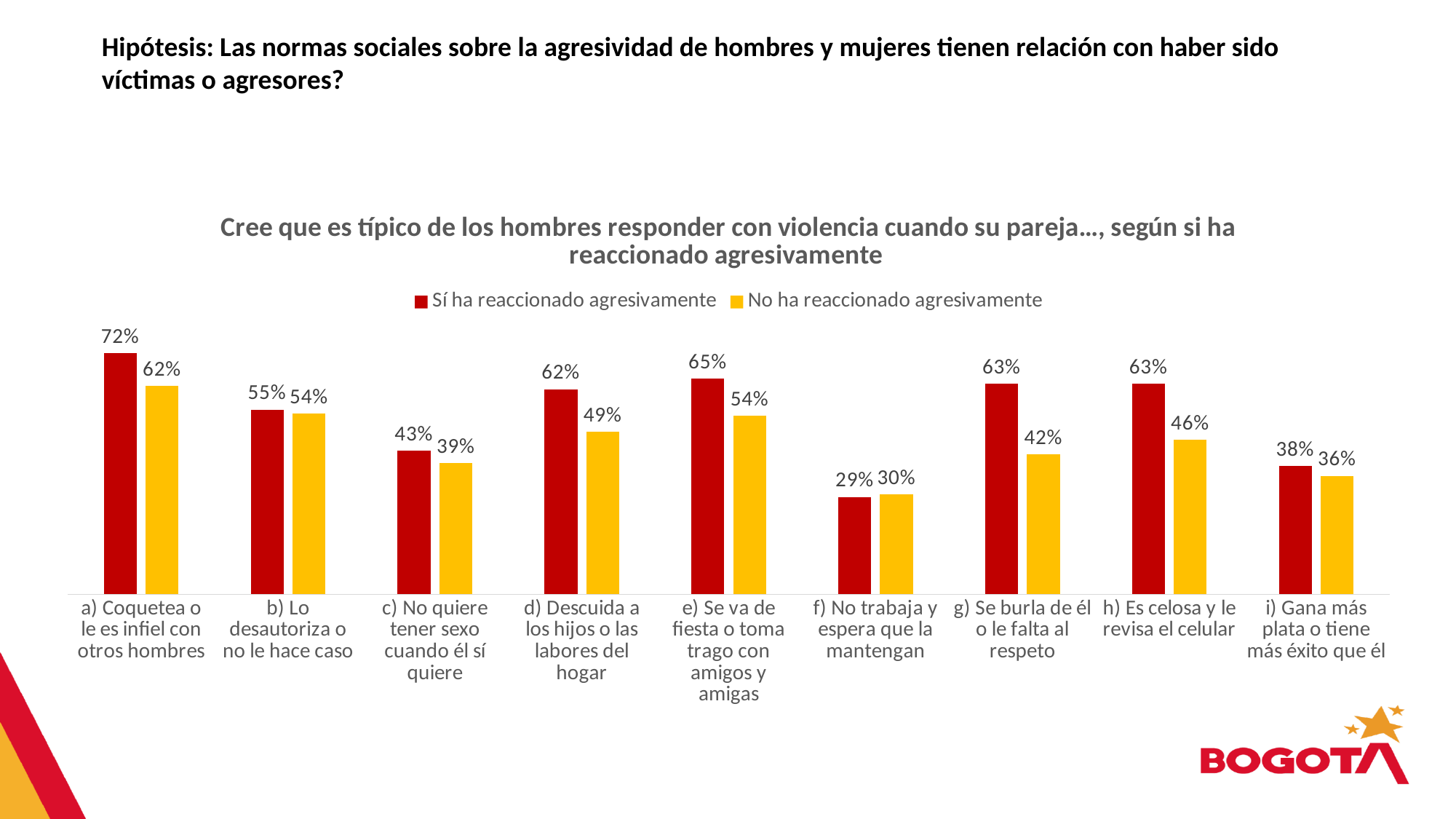
How many series does the legend list? 2 What is the value for 'No ha reaccionado agresivamente' for category f) No trabaja y espera que la mantengan? 30% What is the difference between the 'Sí ha reaccionado agresivamente' and 'No ha reaccionado agresivamente' values for category h) Es celosa y le revisa el celular? 17% How many categories are shown on the x axis? 9 For category f) No trabaja y espera que la mantengan, which series has the larger value? No ha reaccionado agresivamente What is the value for 'No ha reaccionado agresivamente' for category g) Se burla de él o le falta al respeto? 42% Which category has the lowest value for 'No ha reaccionado agresivamente'? f) No trabaja y espera que la mantengan What is the value for 'Sí ha reaccionado agresivamente' for category a) Coquetea o le es infiel con otros hombres? 72% What kind of chart is shown on the slide? Bar chart What is the difference between the 'Sí ha reaccionado agresivamente' and 'No ha reaccionado agresivamente' values for category g) Se burla de él o le falta al respeto? 21% Which is larger: the 'Sí ha reaccionado agresivamente' value for e) Se va de fiesta o toma trago con amigos y amigas, or for d) Descuida a los hijos o las labores del hogar? e) Se va de fiesta o toma trago con amigos y amigas Which category has the highest value for 'Sí ha reaccionado agresivamente'? a) Coquetea o le es infiel con otros hombres